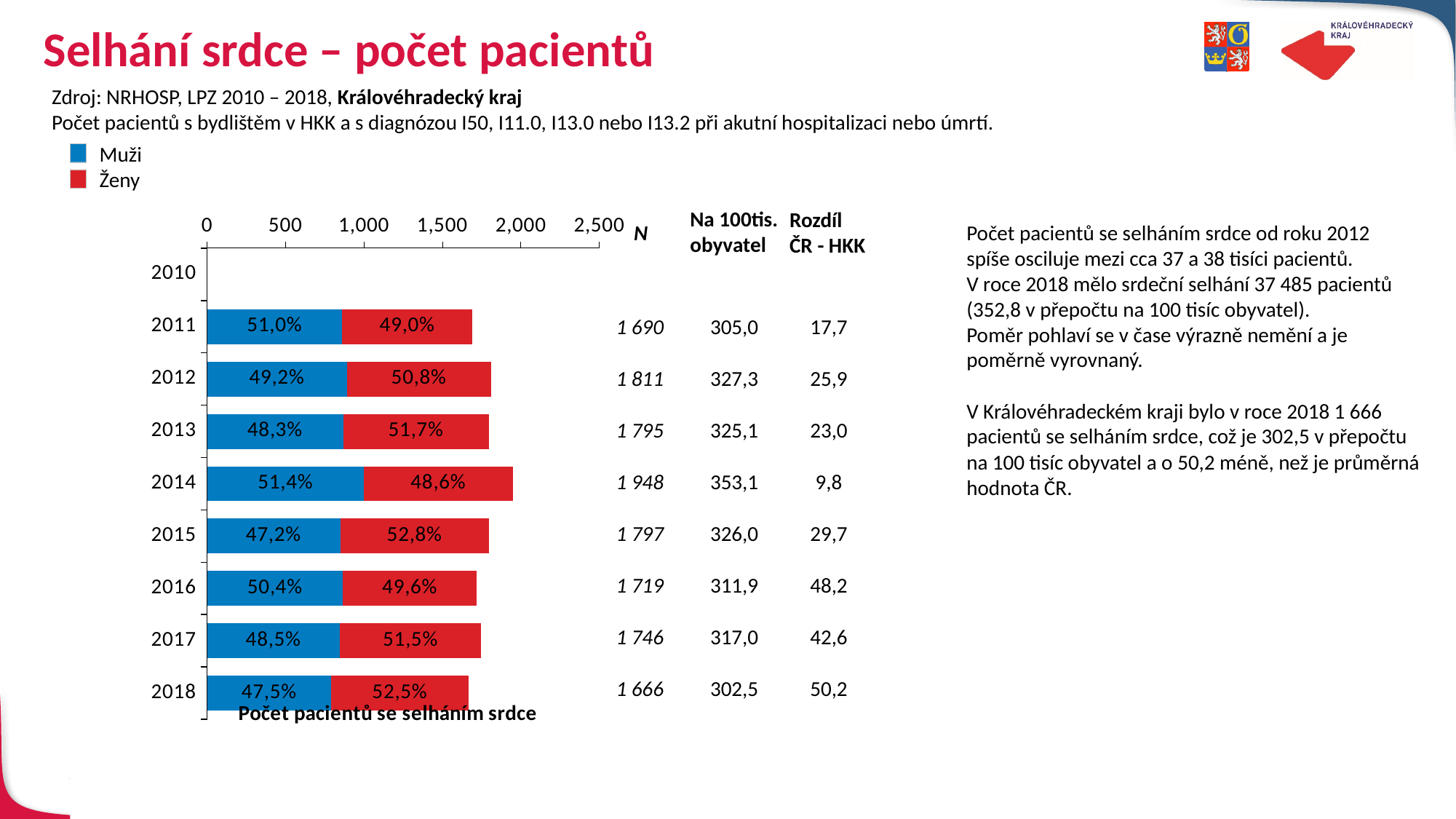
How many series does the legend list? 2 In 2012, which share is larger, Muži or Ženy? Ženy How many years on the axis have a bar plotted? 8 What are the two series named in the legend? Muži and Ženy What is the Muži share shown for 2018? 47,5% What is the Muži share shown for 2011? 51,0% What is the Ženy share shown for 2014? 48,6% What kind of chart is shown on the slide? bar chart Which year has the longest total bar? 2014 Is the total bar for 2018 greater or less than 2,000? less Is the total bar for 2014 greater or less than 1,500? greater What is the Ženy share shown for 2015? 52,8%